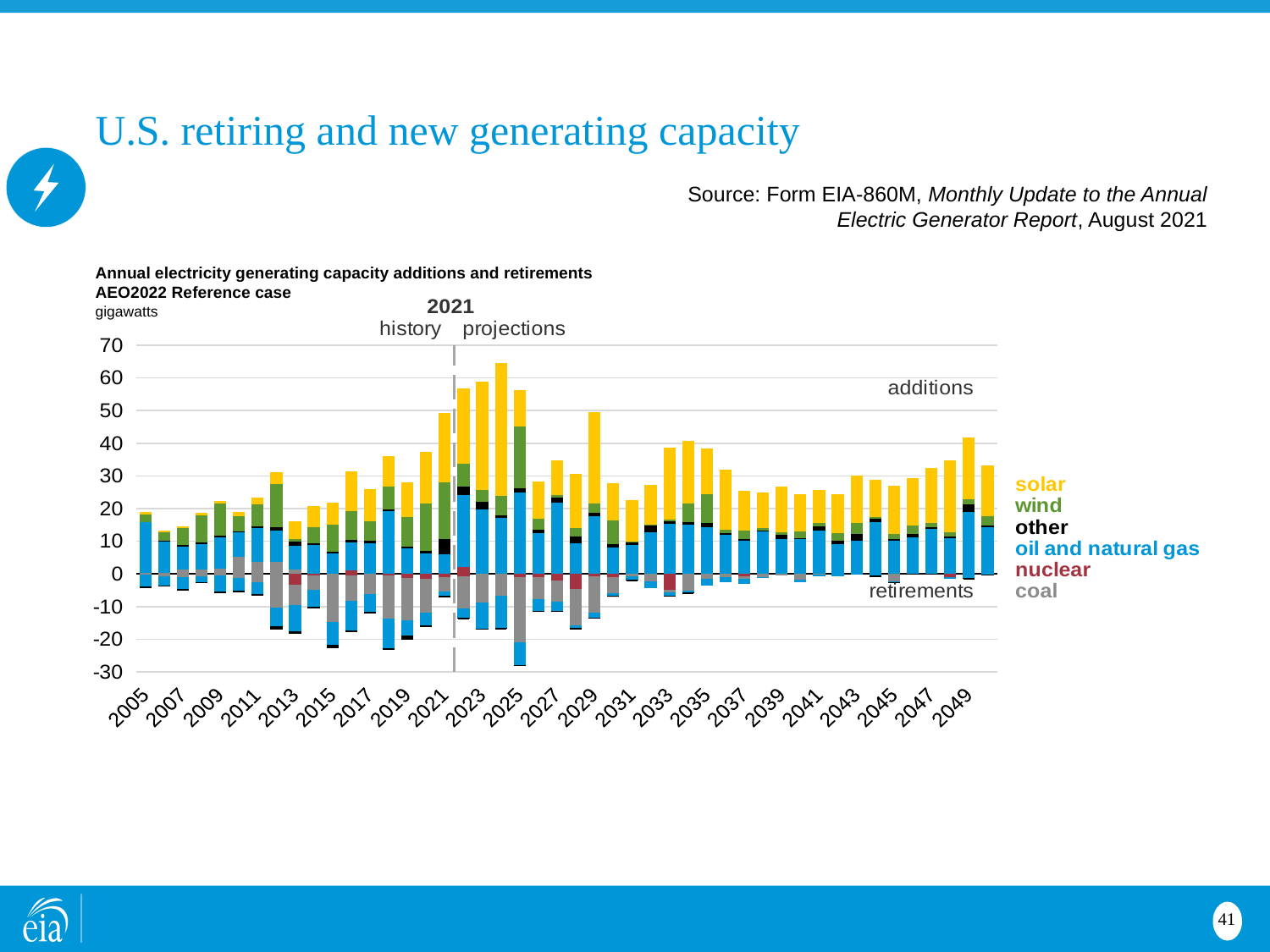
Is the total additions value for 2037 greater or less than 30? less In which year does the retirements bar (below zero) extend the furthest down? 2025 Which year has larger total additions, 2022 or 2013? 2022 Which year separates history from projections on the chart? 2021 Is the total additions value for 2025 greater or less than 60? less Is the total additions value for 2022 greater or less than 50? greater In which year is the additions bar (above zero) the tallest? 2024 What kind of chart is shown on the slide? bar chart What unit is the y axis measured in? gigawatts Do total additions generally rise or fall from 2037 to 2049? rise How many series does the legend list? 6